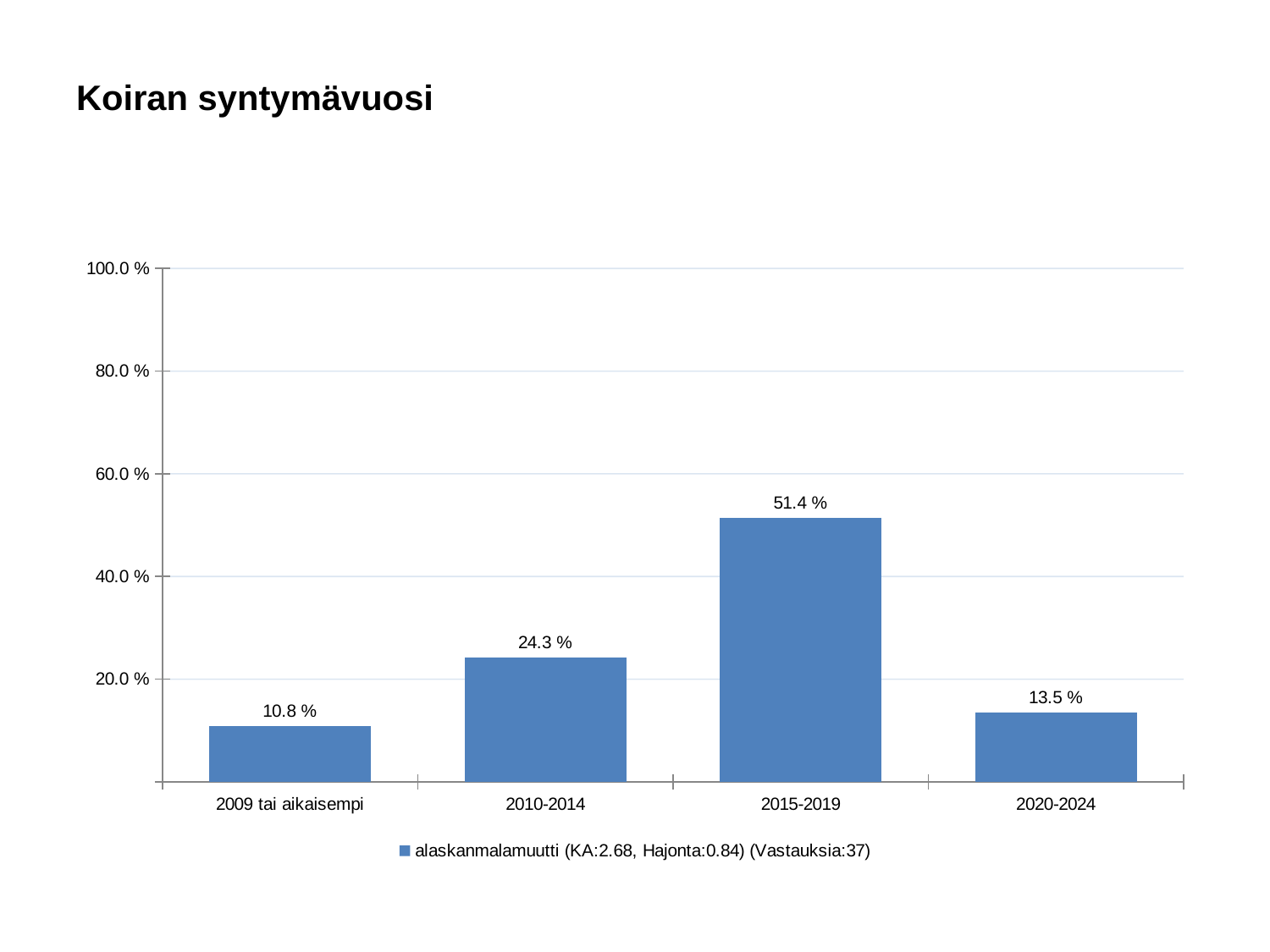
Which category has the highest value? 2015-2019 What is the difference between the values for 2015-2019 and 2010-2014? 27.1 % How many categories are shown on the x axis? 4 What is the value for 2020-2024? 13.5 % What kind of chart is shown on the slide? bar chart Which category has the lowest value? 2009 tai aikaisempi What is the value for 2009 tai aikaisempi? 10.8 % Which is larger, the value for 2010-2014 or the value for 2020-2024? 2010-2014 What is the title of the slide? Koiran syntymävuosi Is the value for 2015-2019 greater or less than 40.0 %? greater What is the value for 2015-2019? 51.4 % How many series does the legend list? 1